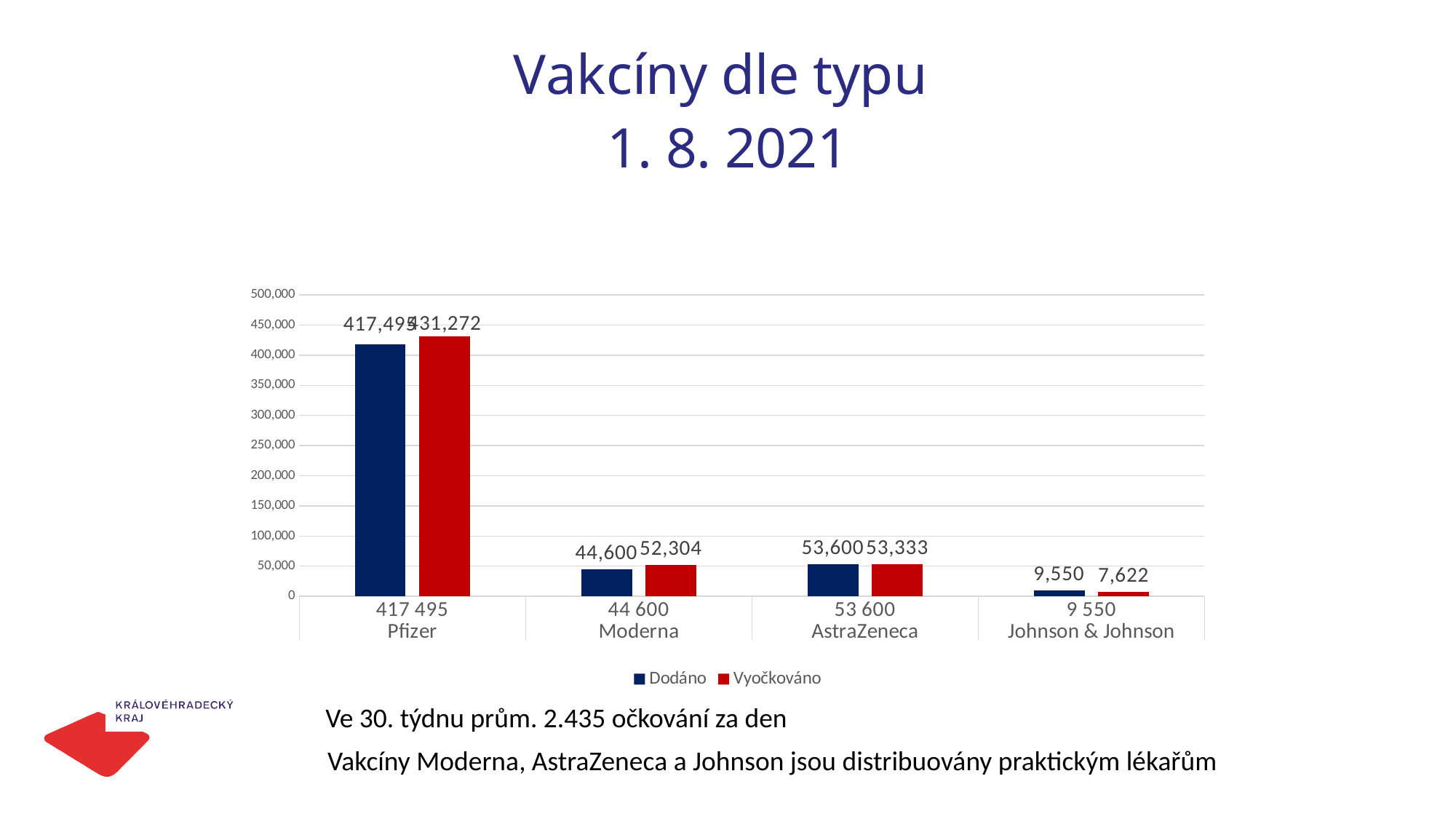
What is the difference between the Vyočkováno and Dodáno values for Moderna? 7,704 Which vaccine has the lowest Vyočkováno value? Johnson & Johnson What is the Dodáno value for Moderna? 44,600 What are the two series named in the legend? Dodáno and Vyočkováno What type of chart is shown on the slide? bar chart What is the Vyočkováno value for Johnson & Johnson? 7,622 Which vaccine has the highest Dodáno value? Pfizer For Johnson & Johnson, which is larger: Dodáno or Vyočkováno? Dodáno What is the Dodáno value for Pfizer? 417,495 What is the Vyočkováno value for AstraZeneca? 53,333 How many vaccine types (categories) are shown on the x axis? 4 How many series does the legend list? 2